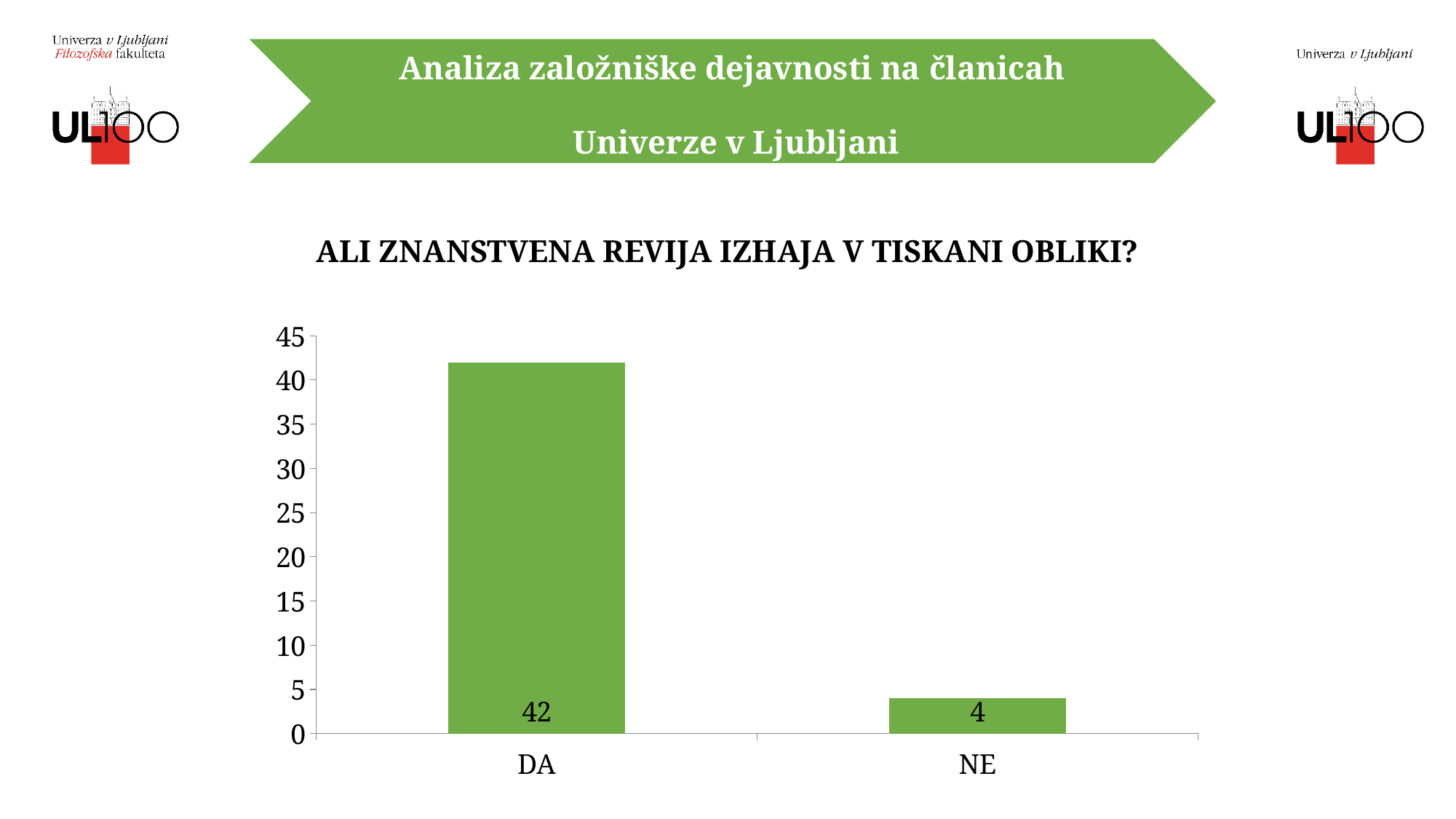
Which category has the lowest value? NE What is the total of the two bars? 46 What kind of chart is shown on the slide? bar chart Which category has the highest value? DA What is the value for DA? 42 What question does the chart title ask? ALI ZNANSTVENA REVIJA IZHAJA V TISKANI OBLIKI? How many categories are shown on the x axis? 2 What is the value for NE? 4 What is the difference between the values for DA and NE? 38 Is the value for DA greater or less than 40? greater Which is larger, the value for DA or the value for NE? DA Is the value for NE greater or less than 5? less